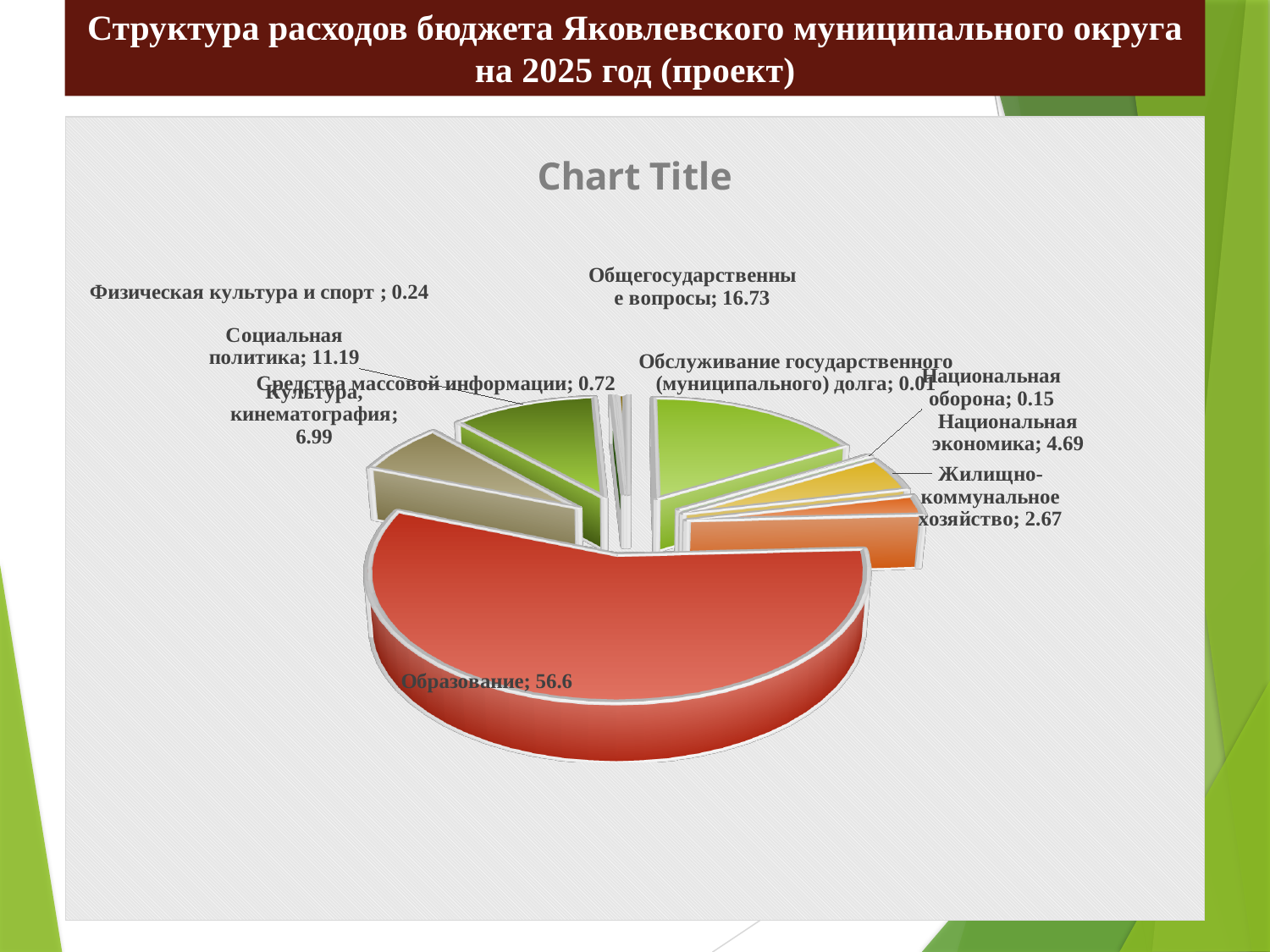
Which is larger: Национальная экономика or Жилищно-коммунальное хозяйство? Национальная экономика What is the title displayed above the pie chart? Chart Title Which category has the largest share of the pie? Образование What is the value for Образование? 56.6 Which category has the smallest share of the pie? Обслуживание государственного (муниципального) долга What is the value for Общегосударственные вопросы? 16.73 What is the value for Социальная политика? 11.19 How many categories are shown in the pie chart? 10 What is the value for Национальная экономика? 4.69 What is the difference between the values for Общегосударственные вопросы and Социальная политика? 5.54 What type of chart is shown on the slide? pie chart What is the value for Культура, кинематография? 6.99